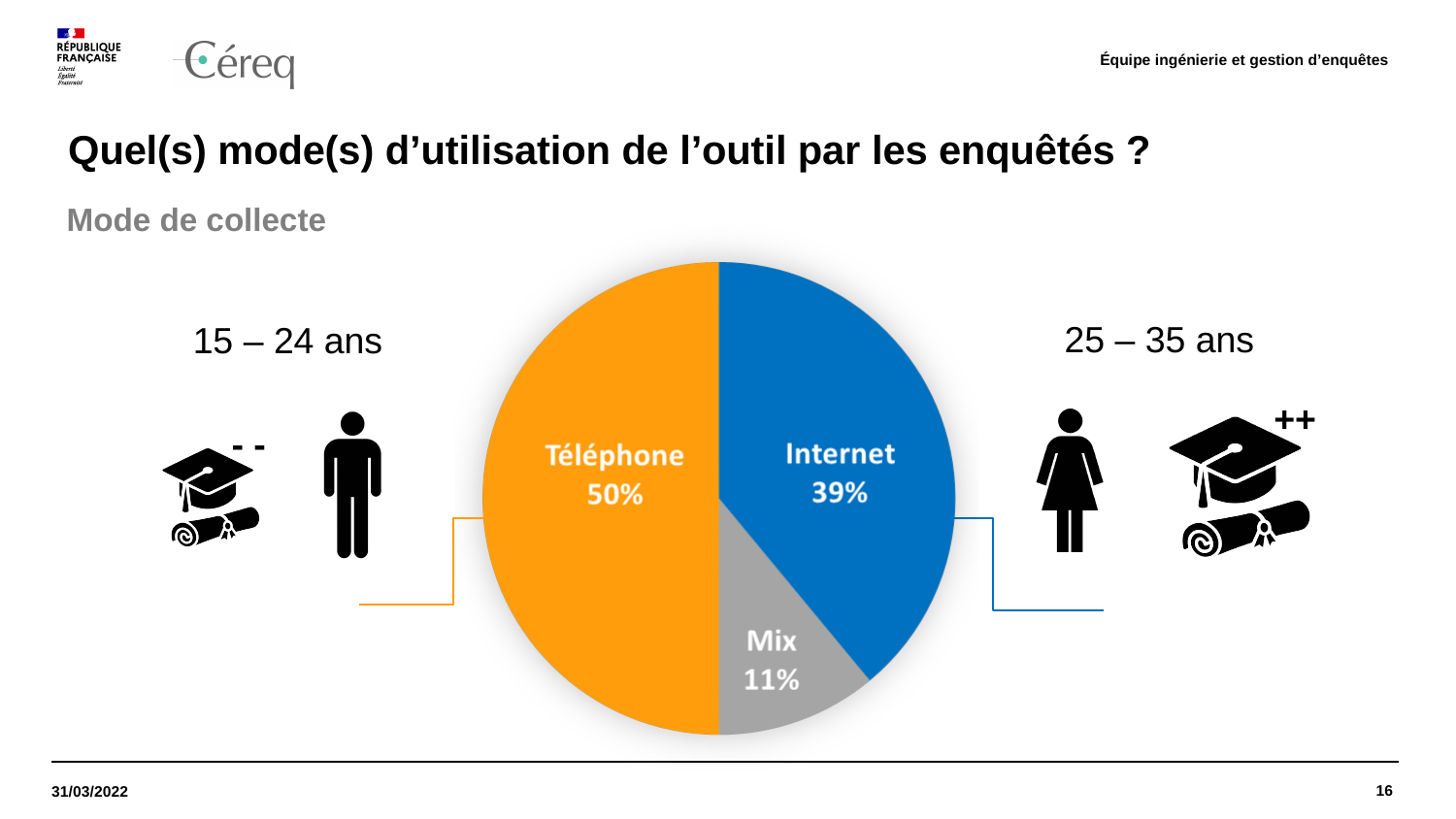
Which collection mode has the smallest share in the pie chart? Mix What share of the pie chart does Téléphone represent? 50% How many slices does the pie chart have? 3 Which has a larger share, Internet or Mix? Internet What kind of chart is shown on the slide? Pie chart What is the difference in percentage points between the Téléphone and Internet shares? 11 What colour is the Internet slice of the pie chart? Blue Which collection mode has the largest share in the pie chart? Téléphone What colour is the Téléphone slice of the pie chart? Orange What share of the pie chart does Internet represent? 39% What share of the pie chart does Mix represent? 11% What is the difference in percentage points between the Internet and Mix shares? 28